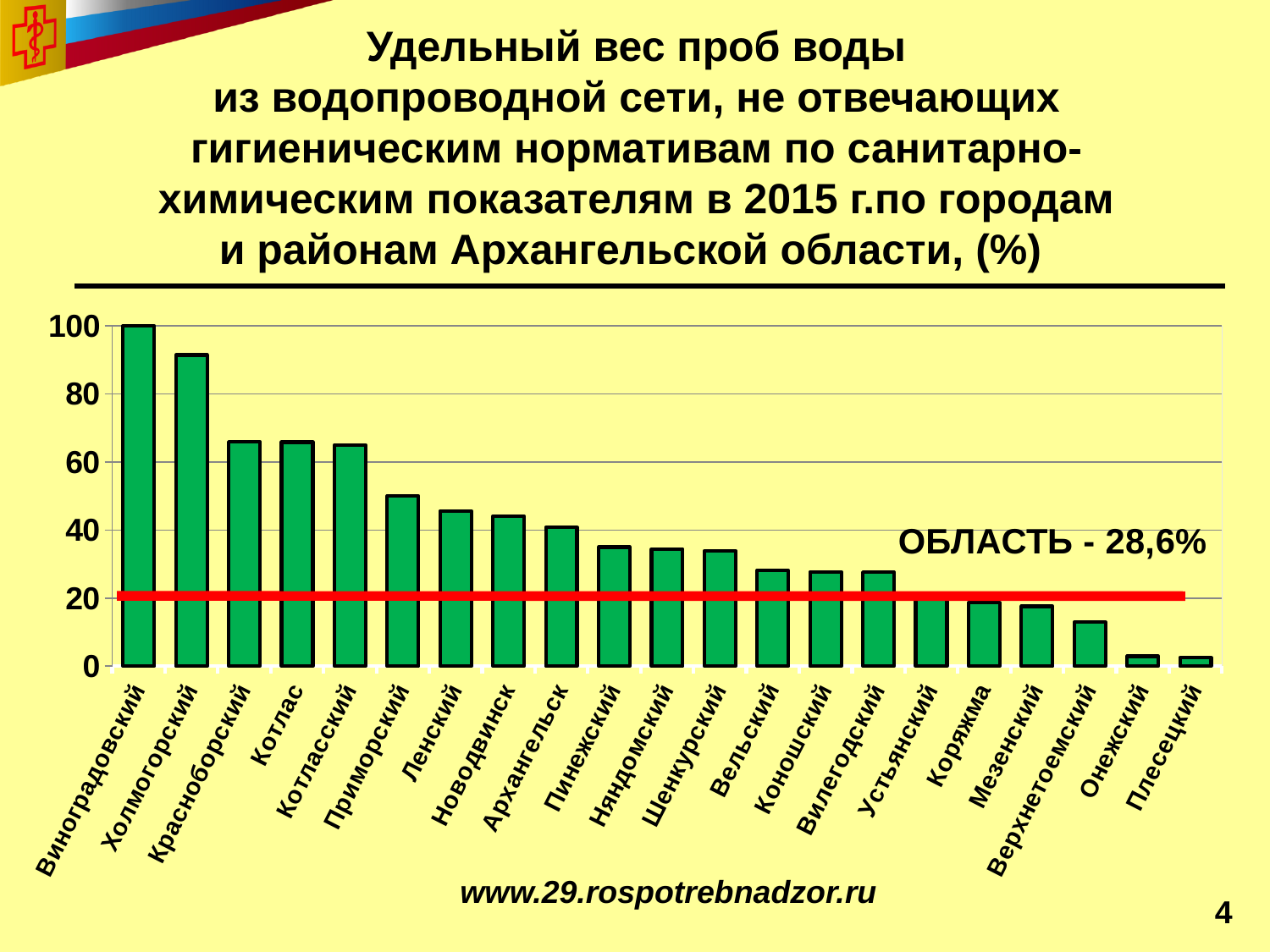
Is the value for Приморский greater or less than 40? greater Is the value for Холмогорский greater or less than 80? greater What is the value for Виноградовский? 100 What kind of chart is shown on the slide? bar chart How many cities and districts are shown on the x axis of the chart? 21 Is the value for Вельский greater or less than 20? greater Which city or district has the highest value in the chart? Виноградовский What value for the region (ОБЛАСТЬ) is annotated on the chart? 28,6% Which has the larger value, Новодвинск or Мезенский? Новодвинск Do the values rise or fall from left to right along the x axis? fall Which has the larger value, Красноборский or Приморский? Красноборский